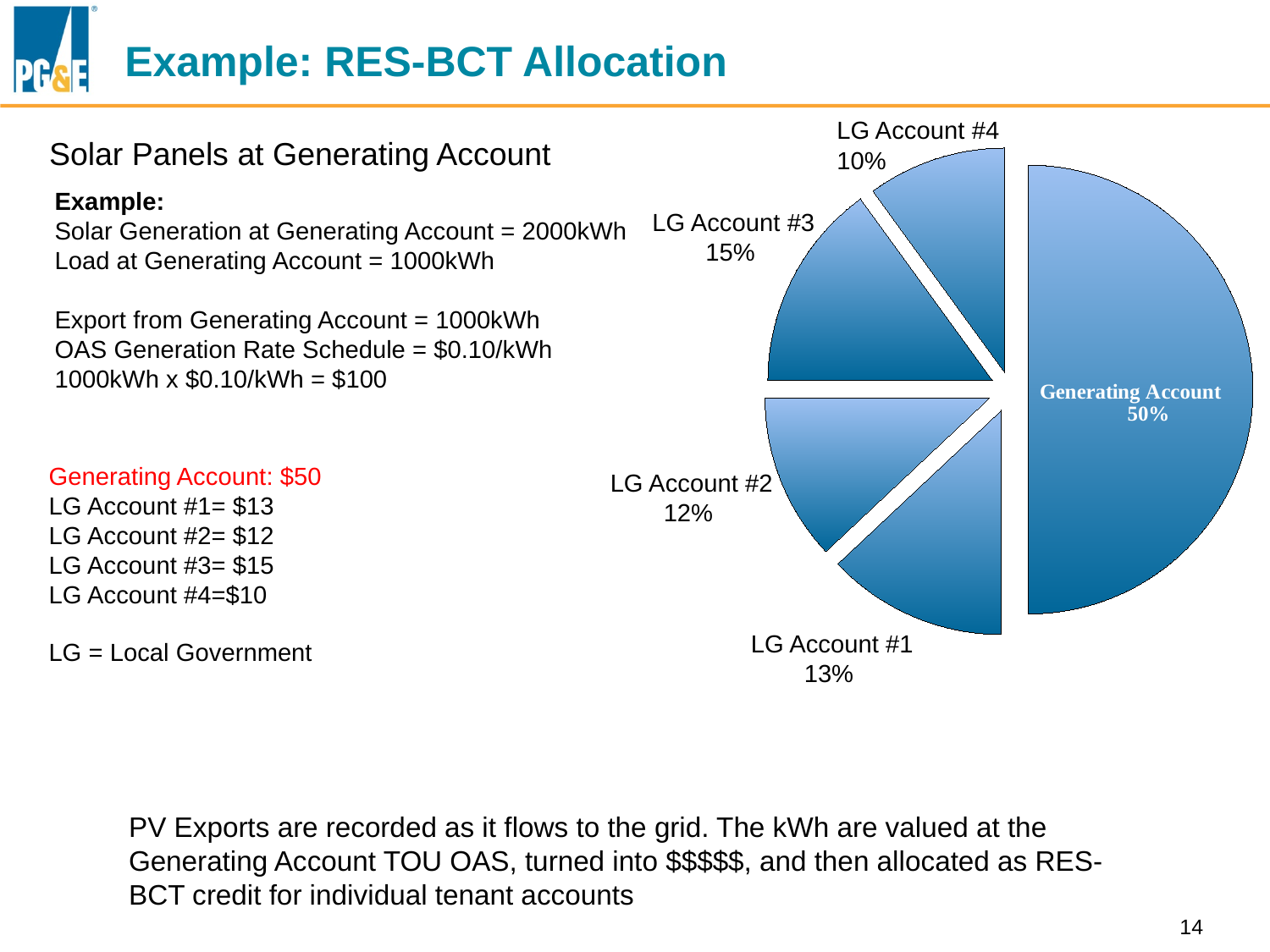
What share of the pie does LG Account #3 have? 15% Which slice of the pie is the largest? Generating Account What share of the pie does LG Account #1 have? 13% What share of the pie does Generating Account have? 50% What share of the pie does LG Account #4 have? 10% What is the difference in percentage points between LG Account #1 and LG Account #2? 1 What kind of chart is shown on the slide? pie chart Which slice of the pie is labelled in bold text inside the slice? Generating Account Which slice of the pie is the smallest? LG Account #4 How many slices does the pie chart have? 5 What is the difference in percentage points between the Generating Account slice and the LG Account #3 slice? 35 Which slice is larger, LG Account #2 or LG Account #3? LG Account #3